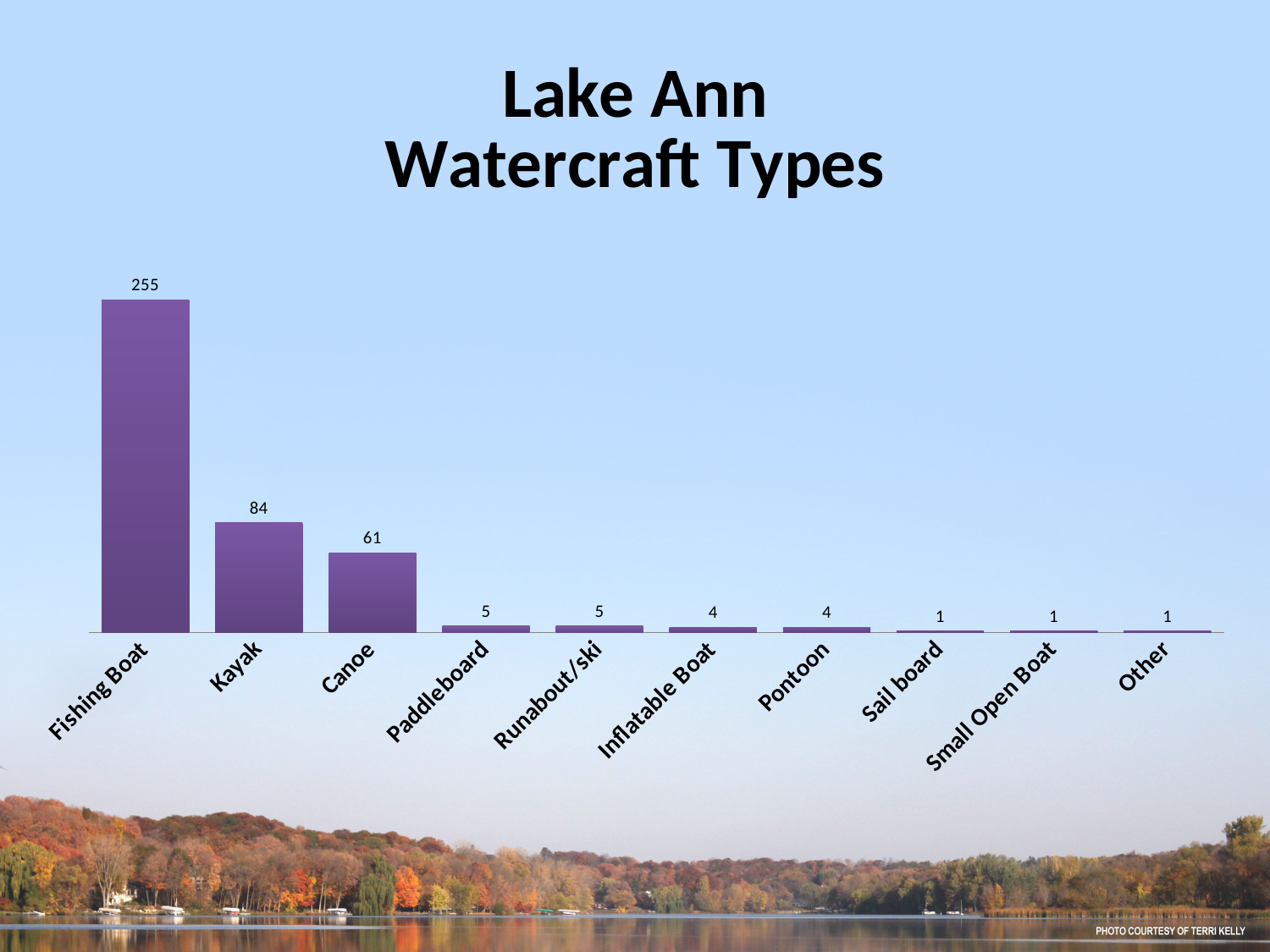
What is the difference between the values for Kayak and Canoe? 23 What is the value for Pontoon? 4 What is the value for Kayak? 84 What is the value for Fishing Boat? 255 Which is larger, the value for Canoe or the value for Paddleboard? Canoe What is the value for Canoe? 61 What is the difference between the values for Fishing Boat and Kayak? 171 Which watercraft type has the highest value? Fishing Boat What is the title of the chart? Lake Ann Watercraft Types Do the values generally rise or fall from left to right along the x axis? Fall How many watercraft types are shown on the chart? 10 What kind of chart is shown on the slide? Bar chart